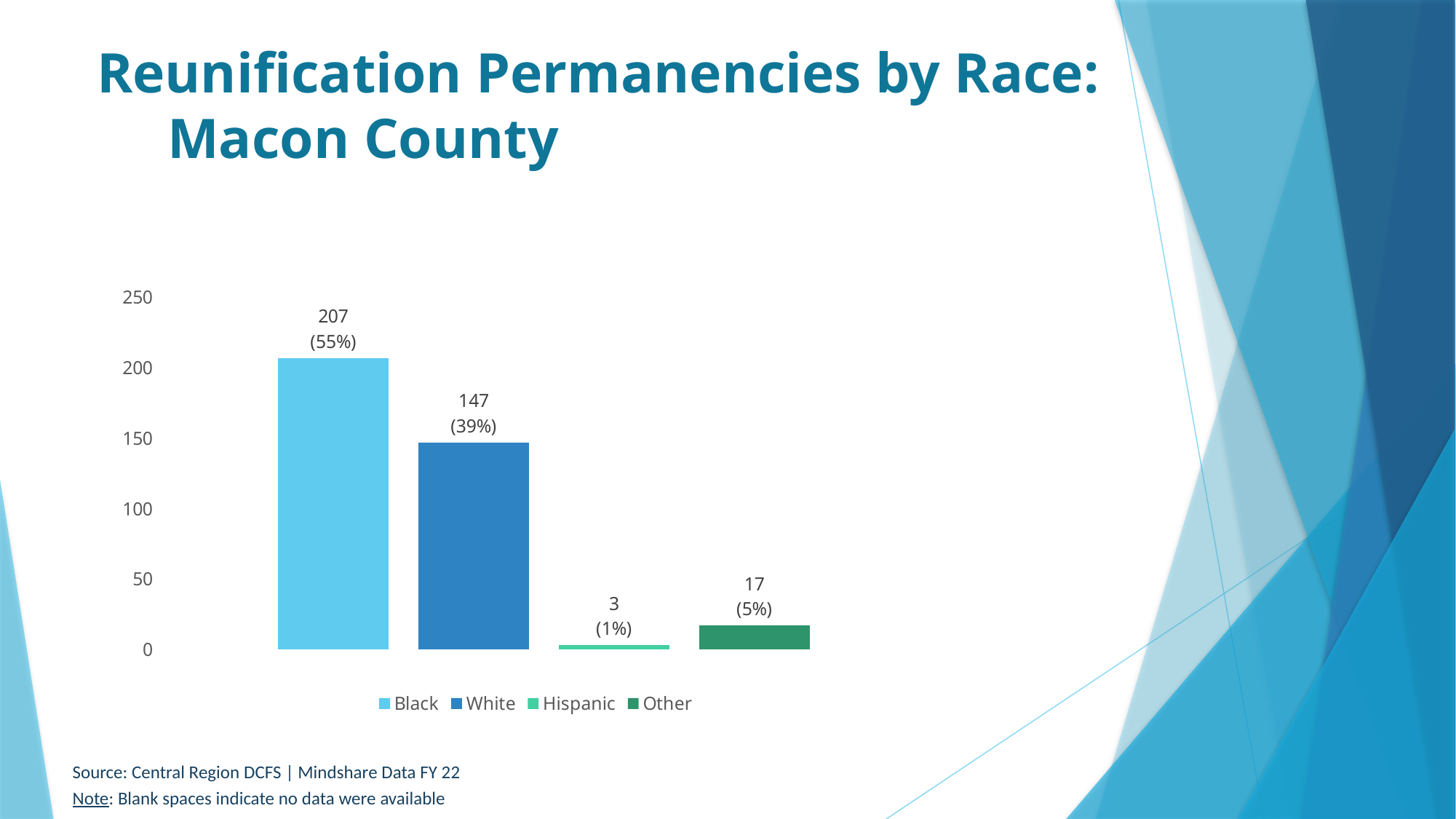
What percentage of reunification permanencies is shown for Hispanic children? 1% Is the value for White greater or less than 100? greater Which race category has the highest number of reunification permanencies? Black Which race category has the lowest number of reunification permanencies? Hispanic What percentage is shown for the Black category? 55% What is the value shown for the Other category? 17 What is the difference between the Black and White values? 60 What kind of chart is shown on the slide? Bar chart How many race categories are plotted in the chart? 4 What is the number of reunification permanencies for Black children in Macon County? 207 What is the number of reunification permanencies for White children in Macon County? 147 Which is larger, the value for Other or the value for Hispanic? Other